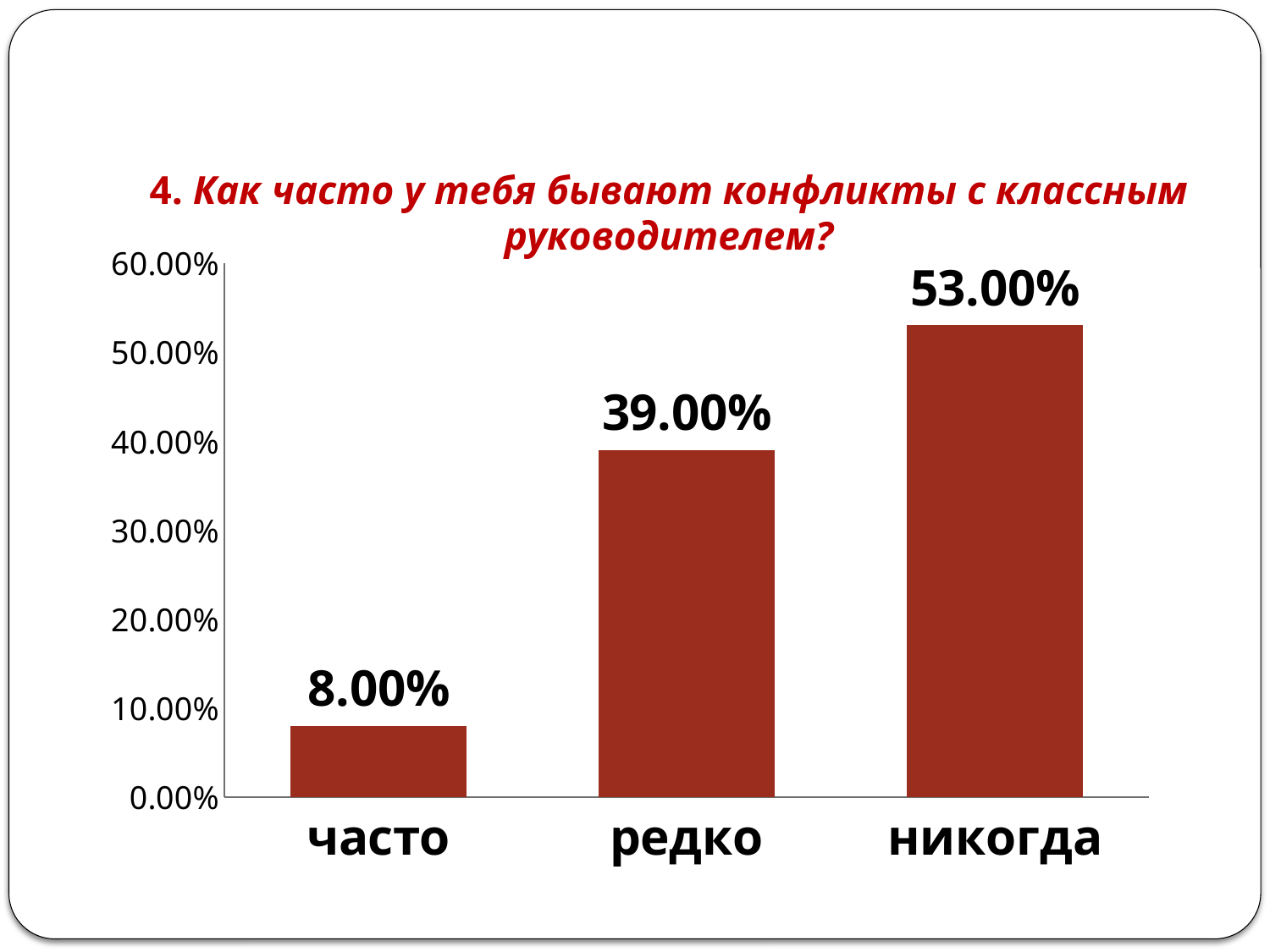
What is the difference between the values for никогда and редко? 14.00% Which category has the lowest value? часто Which is larger, the value for редко or the value for часто? редко What is the value for редко? 39.00% Which category has the highest value? никогда What is the value for никогда? 53.00% What kind of chart is shown on the slide? bar chart What is the value for часто? 8.00% What is the difference between the values for редко and часто? 31.00% Is the value for никогда greater or less than 50.00%? greater How many categories are shown on the x axis? 3 Do the values rise or fall from left to right along the x axis? rise